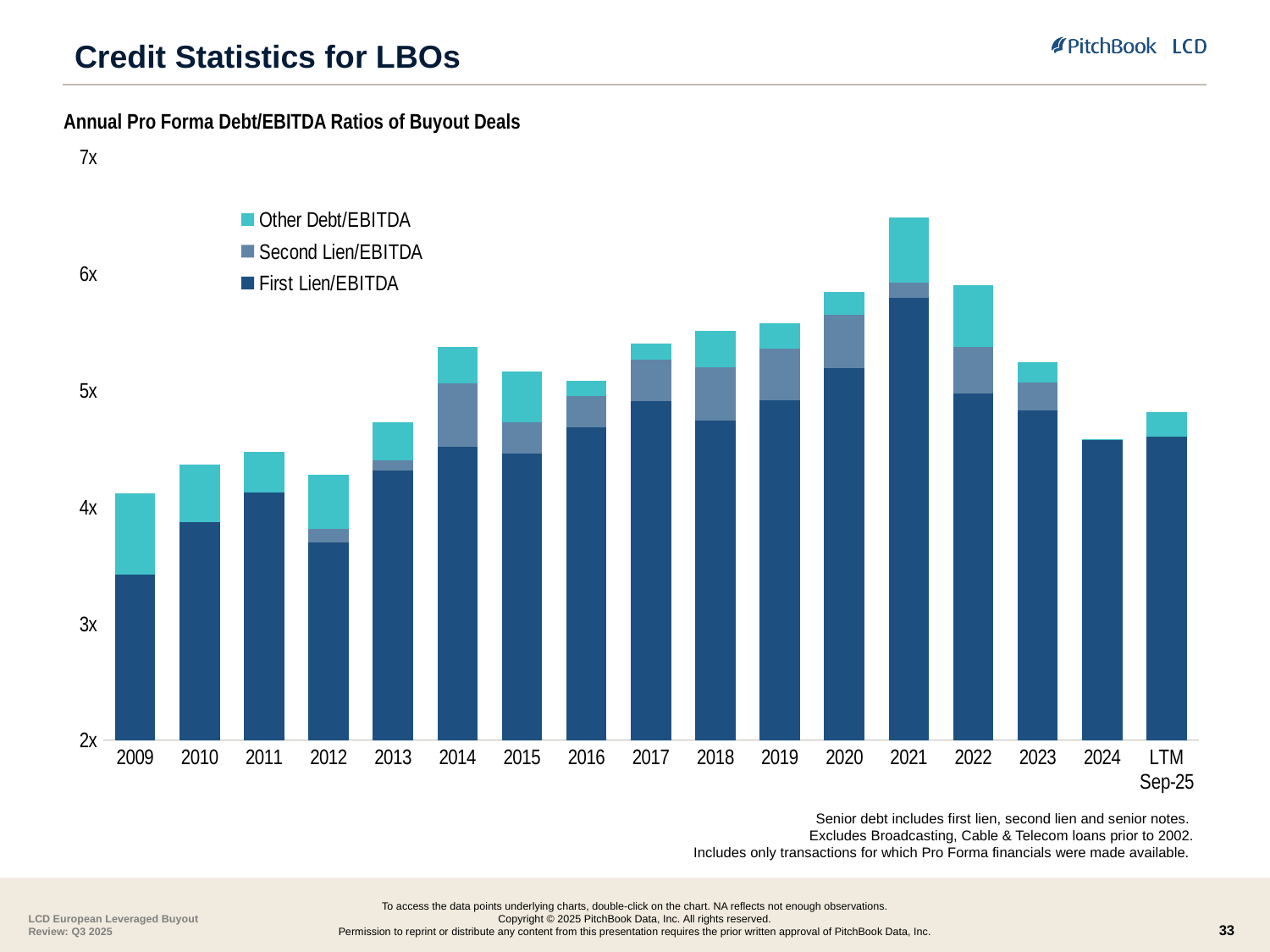
Which series is shown in the darkest blue at the bottom of each bar? First Lien/EBITDA How many series does the legend list? 3 Is the total Debt/EBITDA ratio for 2024 greater or less than 5x? less What kind of chart is shown on the slide? Stacked bar chart Is the total Debt/EBITDA ratio for 2021 greater or less than 6x? greater Is the First Lien/EBITDA value for 2009 greater or less than 4x? less Which year has the lowest total Debt/EBITDA ratio? 2009 Do the total Debt/EBITDA ratios rise or fall from 2021 to 2024? fall How many categories are shown along the x axis? 17 Which year has the highest total Debt/EBITDA ratio? 2021 Which has the larger total Debt/EBITDA ratio, 2021 or 2022? 2021